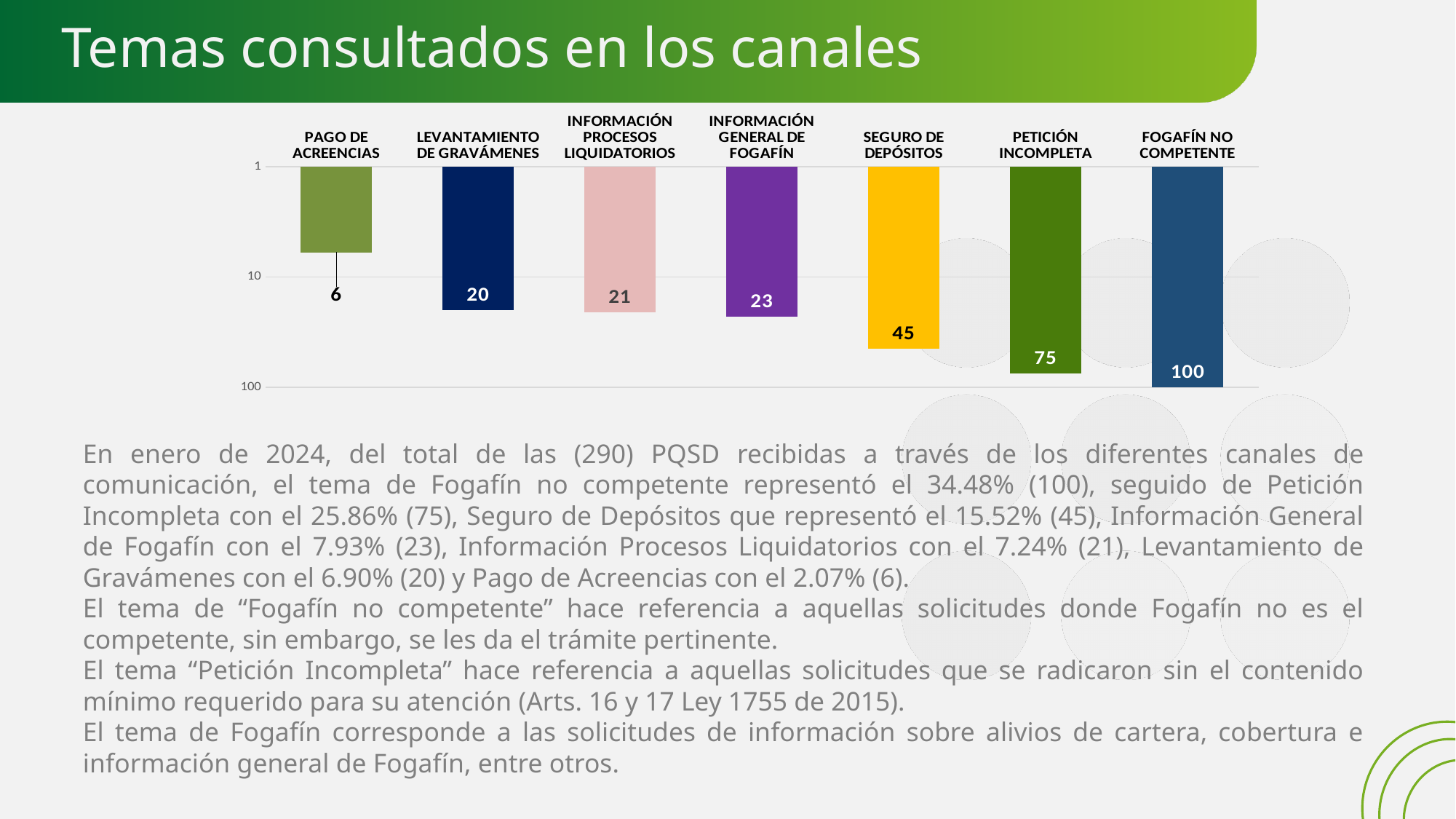
What is the difference between the values for SEGURO DE DEPÓSITOS and LEVANTAMIENTO DE GRAVÁMENES? 25 What is the value for SEGURO DE DEPÓSITOS? 45 What is the value for INFORMACIÓN GENERAL DE FOGAFÍN? 23 What is the value for PETICIÓN INCOMPLETA? 75 What is the difference between the values for FOGAFÍN NO COMPETENTE and PETICIÓN INCOMPLETA? 25 Which is larger, the value for INFORMACIÓN PROCESOS LIQUIDATORIOS or the value for SEGURO DE DEPÓSITOS? SEGURO DE DEPÓSITOS Which category has the highest value? FOGAFÍN NO COMPETENTE What kind of chart is shown on the slide? Bar chart How many categories are shown in the chart? 7 What is the value for PAGO DE ACREENCIAS? 6 Which category has the lowest value? PAGO DE ACREENCIAS What is the title of the slide containing the chart? Temas consultados en los canales